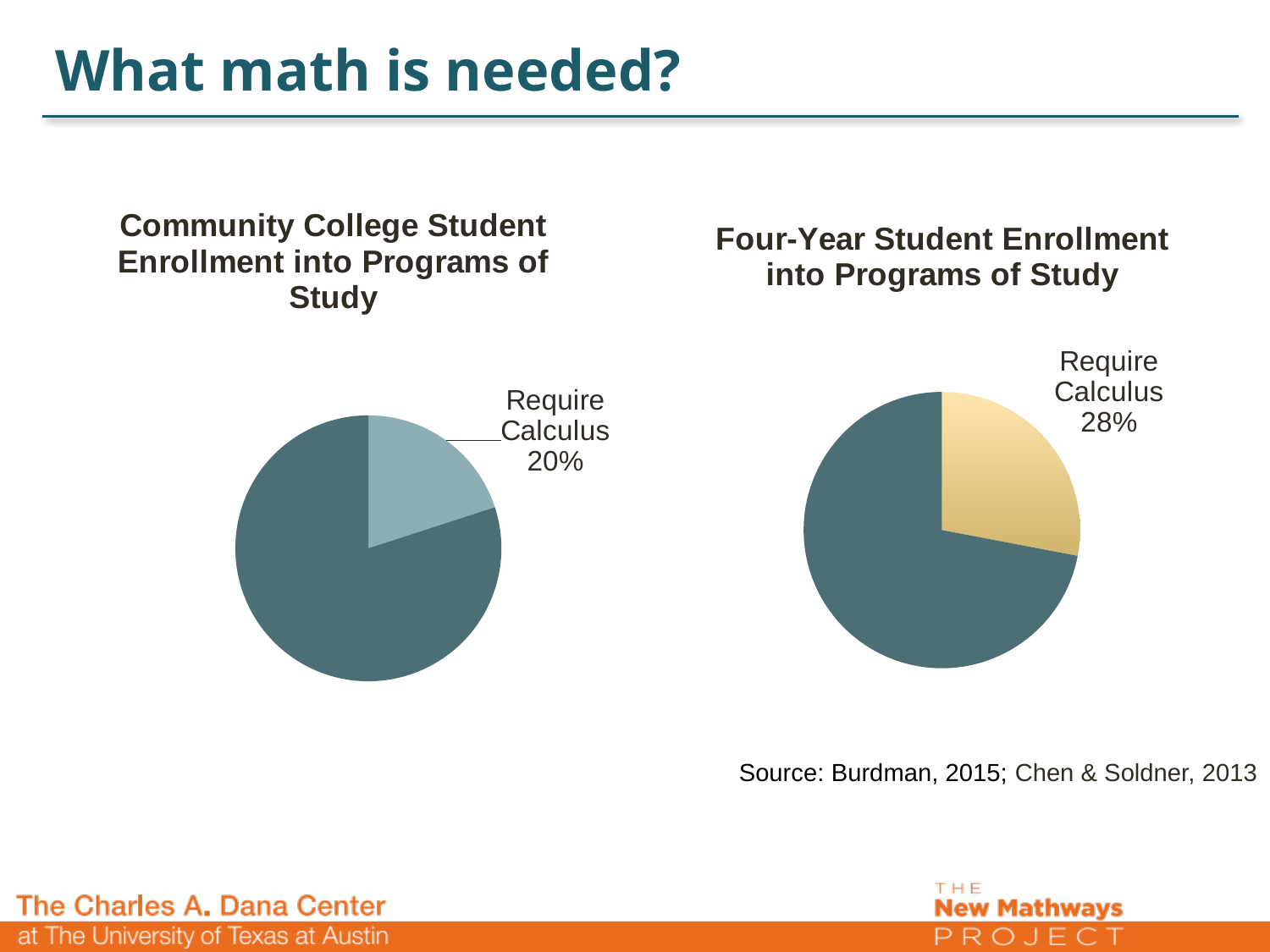
What is the only labeled slice in the 'Community College Student Enrollment into Programs of Study' chart? Require Calculus How many slices does the 'Community College Student Enrollment into Programs of Study' pie chart have? 2 What kind of chart is the 'Four-Year Student Enrollment into Programs of Study' chart? Pie chart In the 'Community College Student Enrollment into Programs of Study' chart, is the 'Require Calculus' slice larger or smaller than the other slice? Smaller Which chart shows a larger 'Require Calculus' share, the Community College chart or the Four-Year chart? Four-Year In the 'Four-Year Student Enrollment into Programs of Study' chart, is the 'Require Calculus' slice larger or smaller than the other slice? Smaller In the 'Four-Year Student Enrollment into Programs of Study' chart, what share of programs require calculus? 28% How many pie charts are shown on the slide? 2 What is the difference between the 'Require Calculus' share in the Four-Year chart and the Community College chart? 8% What is the title of the pie chart on the right side of the slide? Four-Year Student Enrollment into Programs of Study What kind of chart is the 'Community College Student Enrollment into Programs of Study' chart? Pie chart In the 'Community College Student Enrollment into Programs of Study' chart, what share of programs require calculus? 20%